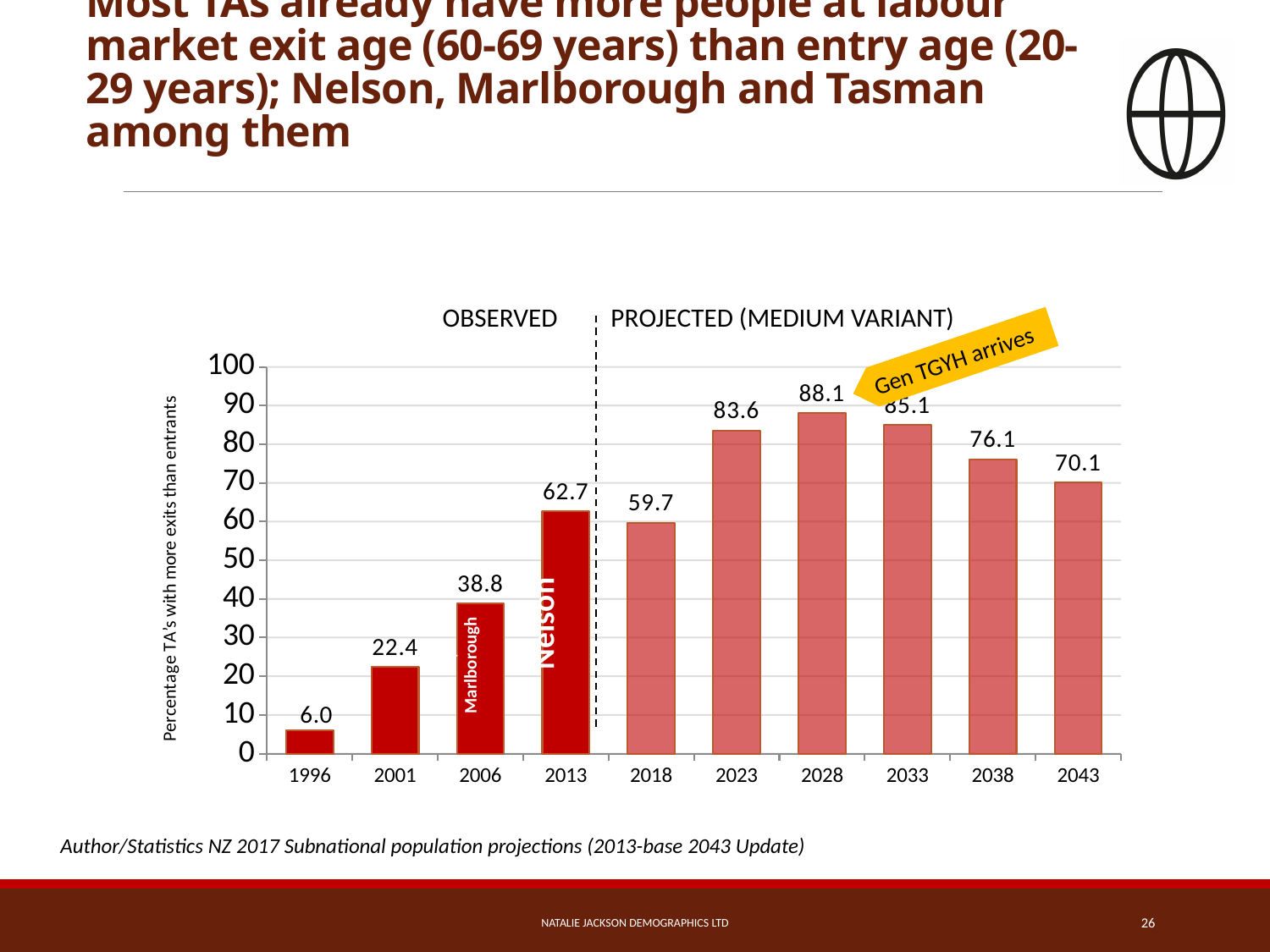
How many years are shown on the x axis? 10 Which is larger, the value for 2023 or the value for 2038? 2023 What is the value for 2013? 62.7 Which year has the lowest value? 1996 What is the value for 2043? 70.1 Which year has the highest value? 2028 What is the value for 1996? 6.0 What type of chart is shown on the slide? bar chart What is the difference between the values for 2013 and 2018? 3.0 What is the value for 2028? 88.1 Do the values rise or fall from 1996 to 2013? rise What is the label on the vertical axis? Percentage TA's with more exits than entrants